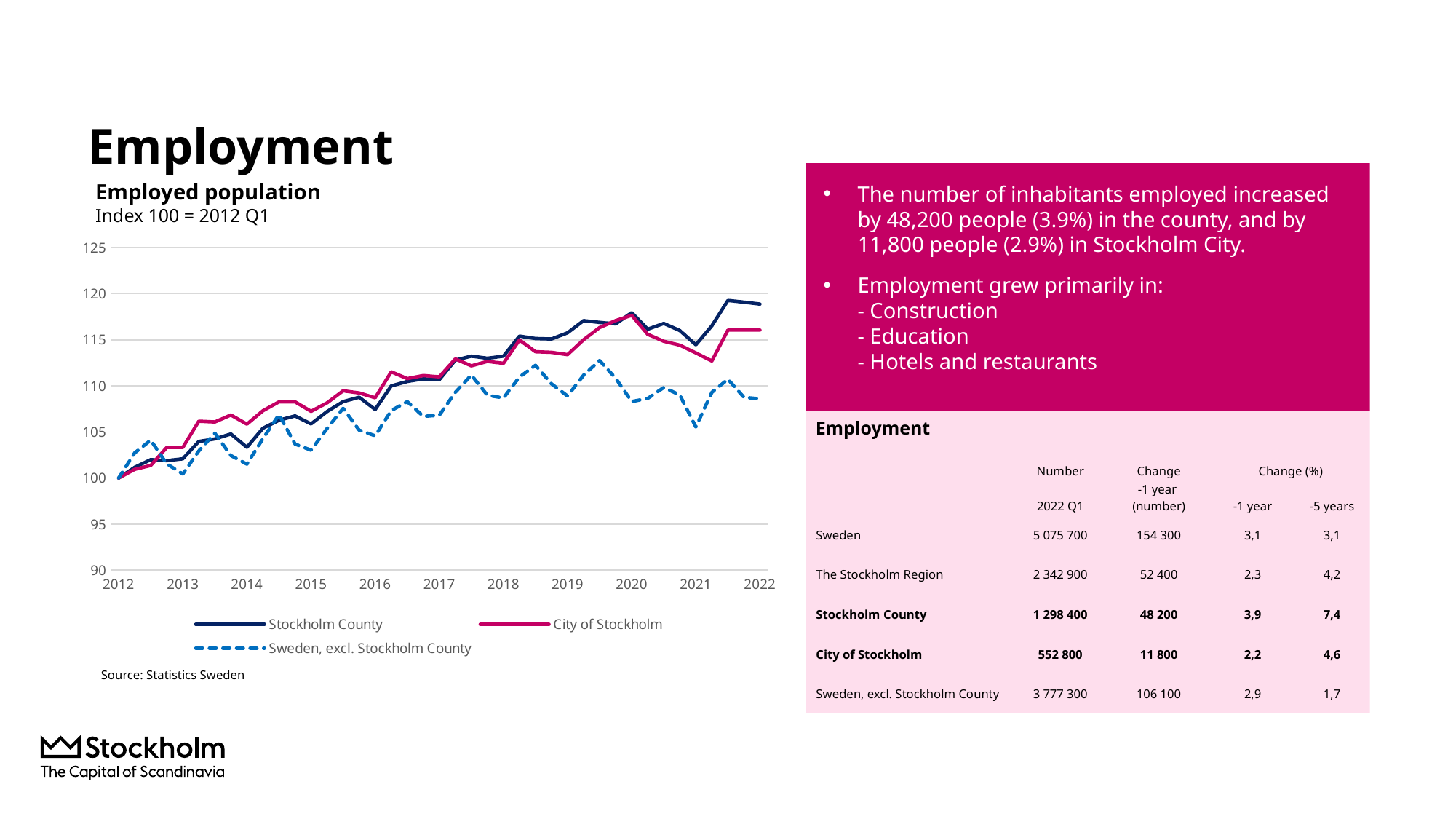
Which series has the lowest index value at 2022? Sweden, excl. Stockholm County How many series does the chart legend list? 3 What kind of chart is shown on the slide? Line chart How many year labels are shown on the x axis of the chart? 11 Does the Stockholm County series generally rise or fall from 2012 to 2022? Rise What is the title of the chart? Employed population At 2022, which is higher: Stockholm County or City of Stockholm? Stockholm County Is the value for Sweden, excl. Stockholm County at 2022 greater or less than 110? less Is the value for Stockholm County at 2022 greater or less than 115? greater Which series has the highest index value at 2022? Stockholm County What is the index value of all three series at the start of the chart in 2012? 100 Which series in the chart is drawn with a dashed line? Sweden, excl. Stockholm County